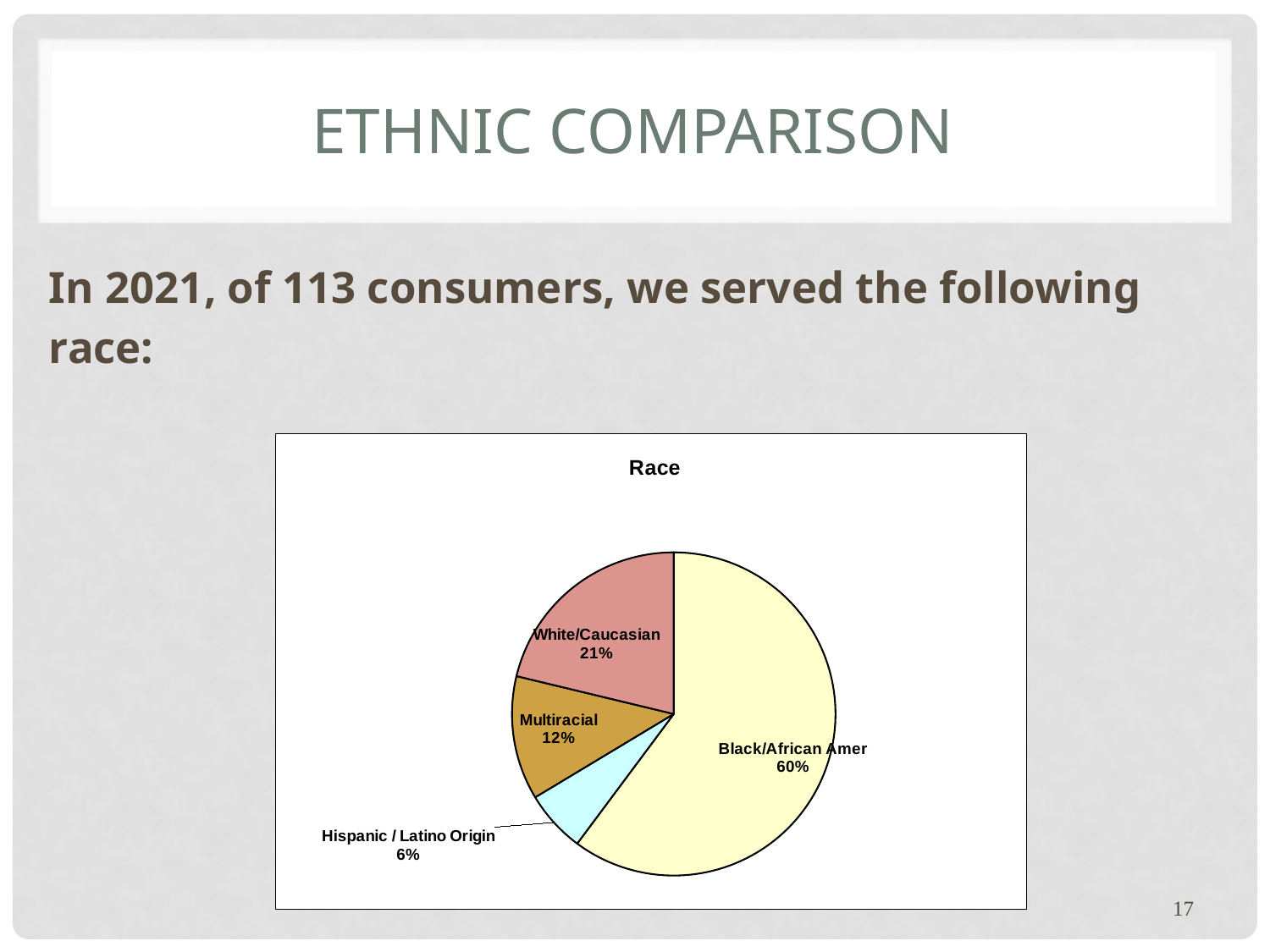
What is the difference in percentage points between the Black/African Amer and White/Caucasian slices? 39 Which is larger, the Multiracial slice or the Hispanic / Latino Origin slice? Multiracial Which category has the largest slice of the pie? Black/African Amer What colour is the Black/African Amer slice? light yellow What share of the pie is Black/African Amer? 60% What is the title of the chart? Race What share of the pie is Hispanic / Latino Origin? 6% Which category has the smallest slice of the pie? Hispanic / Latino Origin What share of the pie is Multiracial? 12% What type of chart is shown on the slide? pie chart How many categories are shown in the pie chart? 4